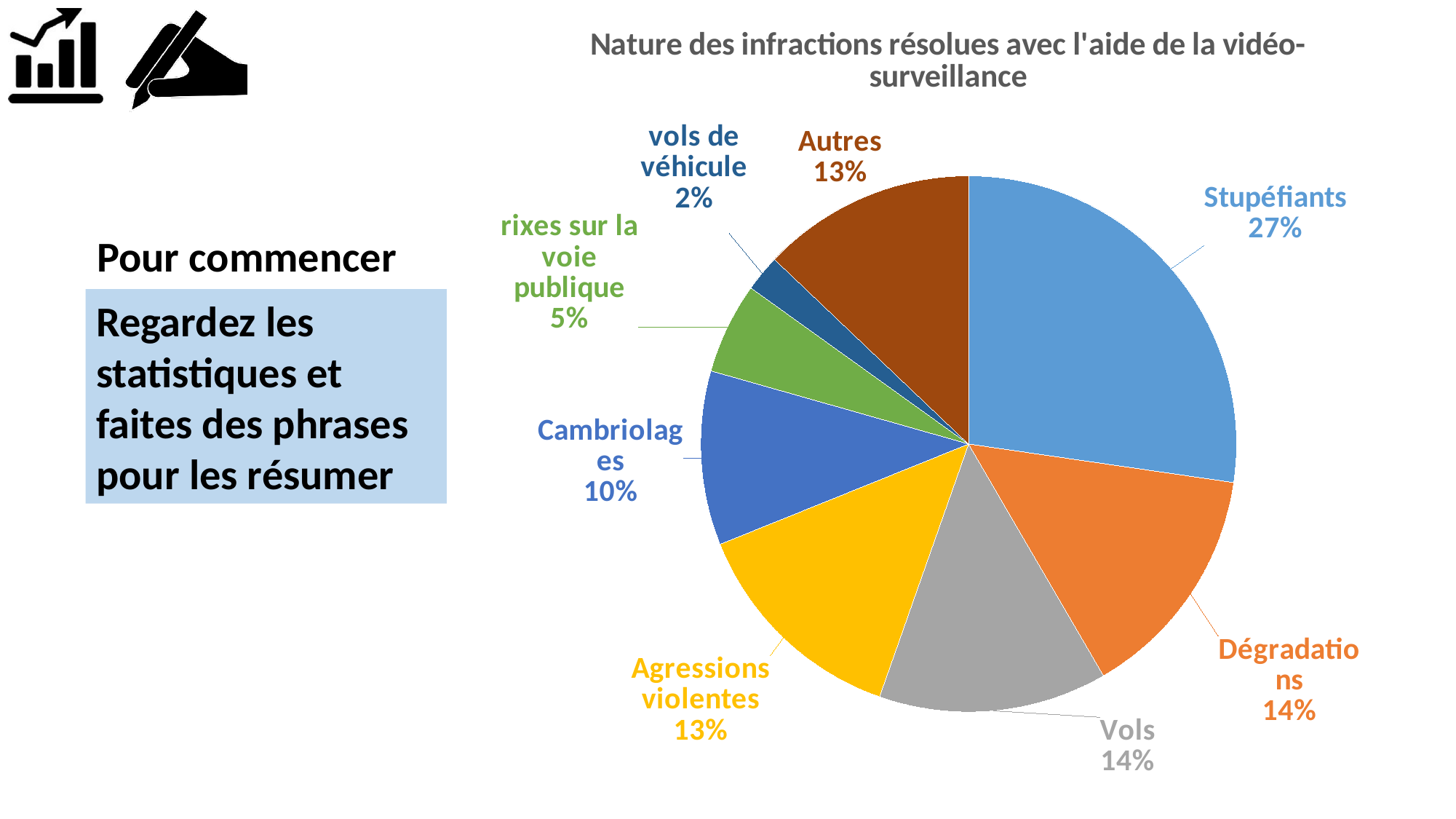
Which category has the largest slice of the pie? Stupéfiants What share of the pie is Stupéfiants? 27% Which is larger, the share for Cambriolages or the share for Agressions violentes? Agressions violentes What percentage is shown for vols de véhicule? 2% Which category has the smallest slice of the pie? vols de véhicule What is the title of the chart? Nature des infractions résolues avec l'aide de la vidéo-surveillance What colour is the Stupéfiants slice? blue What is the difference between the Stupéfiants share and the Vols share? 13% What kind of chart is shown on the slide? pie chart What percentage is shown for Cambriolages? 10% How many categories are shown in the pie chart? 8 What percentage is shown for rixes sur la voie publique? 5%